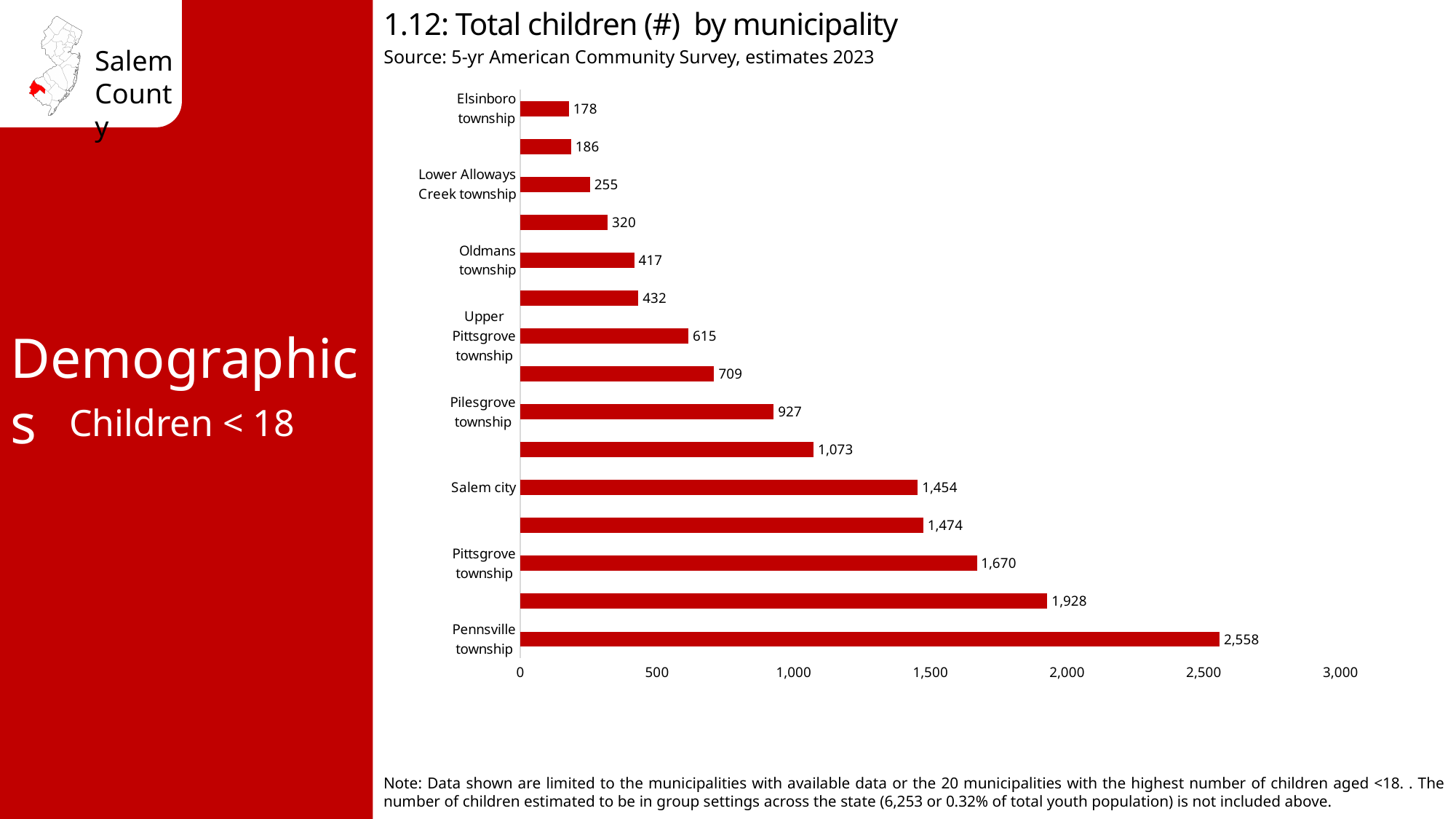
Which municipality has the lowest number of children? Elsinboro township What is the difference in the number of children between Pilesgrove township and Lower Alloways Creek township? 672 Which municipality has the highest number of children? Pennsville township Which has more children, Salem city or Pittsgrove township? Pittsgrove township What is the total number of children for Oldmans township? 417 What kind of chart is shown on the slide? Bar chart What is the total number of children for Upper Pittsgrove township? 615 How many bars are plotted in the chart? 15 What is the total number of children for Pennsville township? 2,558 What is the total number of children for Salem city? 1,454 What is the difference in the number of children between Pennsville township and Pittsgrove township? 888 Is the value for Pilesgrove township greater or less than 1,000? less